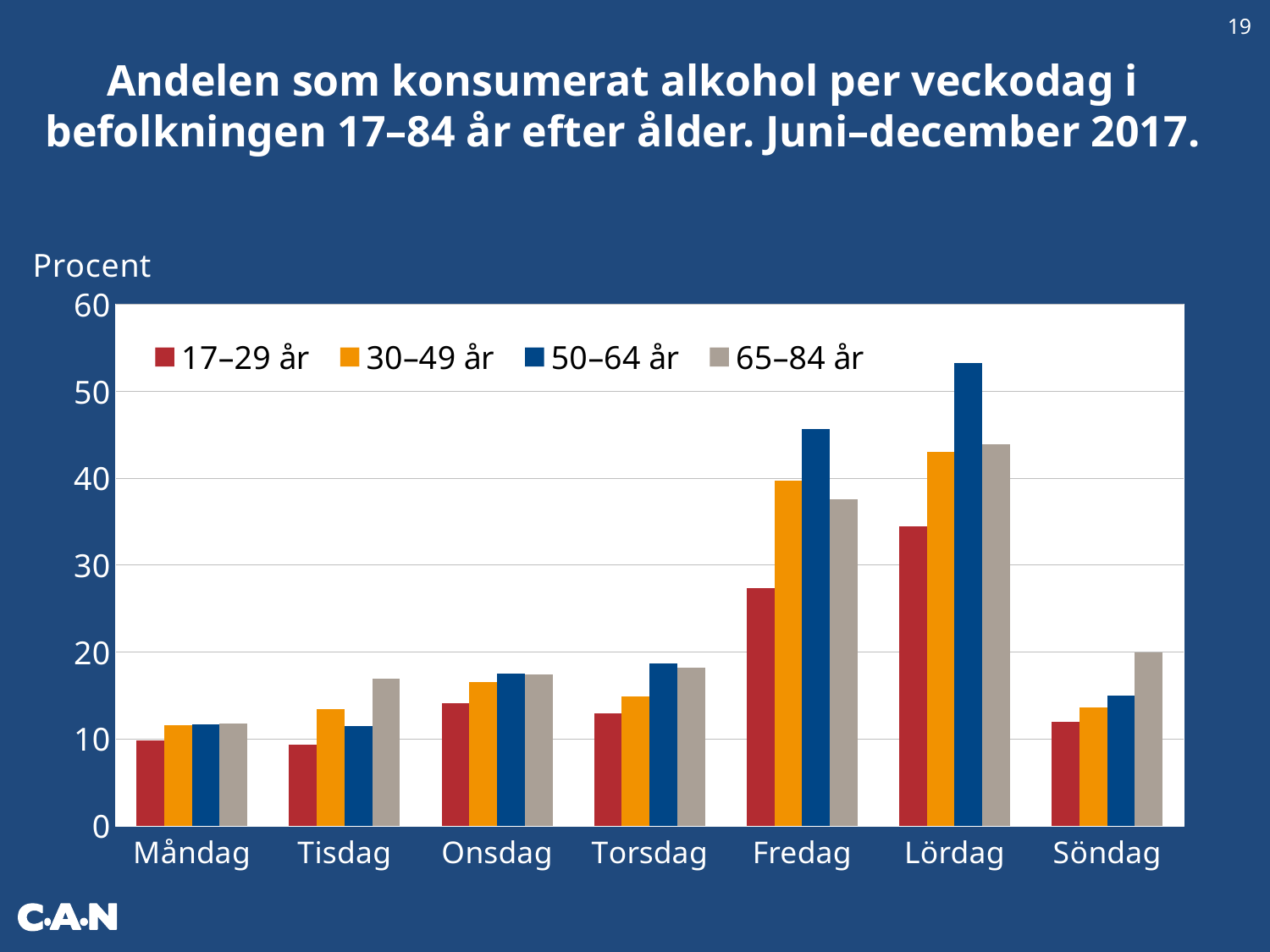
On which weekday is the value for 50–64 år highest? Lördag What label is shown above the y axis? Procent Is the value for 50–64 år on Lördag greater or less than 50? greater For 30–49 år, do the values rise or fall from Torsdag to Lördag? rise Is the value for 65–84 år on Fredag greater or less than 30? greater How many series does the legend list? 4 How many weekdays are shown on the x axis? 7 On Fredag, which is larger: the value for 50–64 år or for 30–49 år? 50–64 år On Tisdag, which is larger: the value for 65–84 år or for 17–29 år? 65–84 år Is the value for 17–29 år on Fredag greater or less than 30? less Which age group has the lowest value on Lördag? 17–29 år What kind of chart is shown on the slide? bar chart